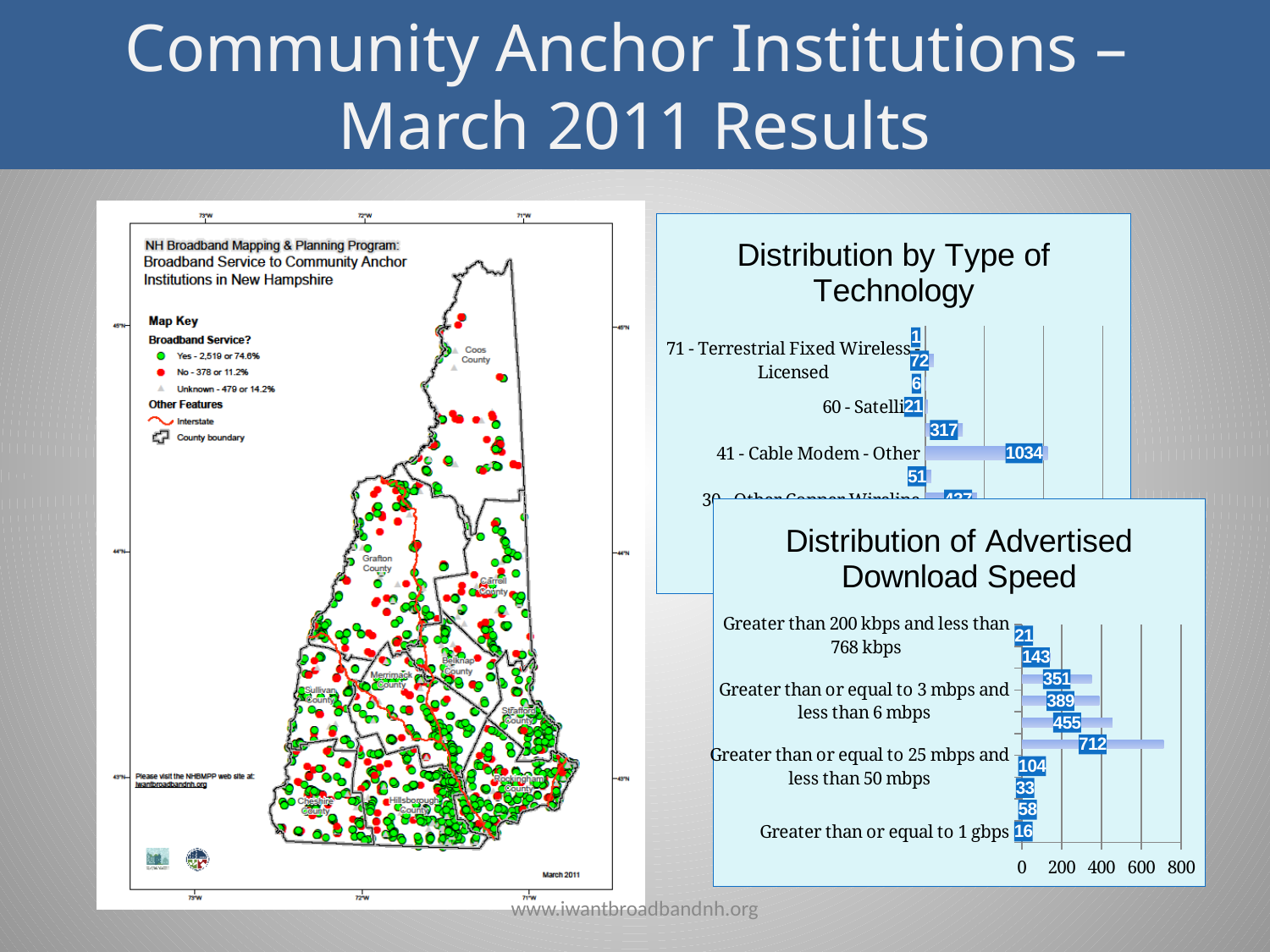
What kind of chart is the 'Distribution of Advertised Download Speed' chart? bar chart In the 'Distribution of Advertised Download Speed' chart, what is the value for 'Greater than or equal to 1 gbps'? 16 In the 'Distribution of Advertised Download Speed' chart, what is the value for 'Greater than 200 kbps and less than 768 kbps'? 21 In the 'Distribution of Advertised Download Speed' chart, what is the value for 'Greater than or equal to 3 mbps and less than 6 mbps'? 389 In the 'Distribution of Advertised Download Speed' chart, what is the value for 'Greater than or equal to 25 mbps and less than 50 mbps'? 104 In the 'Distribution of Advertised Download Speed' chart, is the longest bar greater or less than 600? greater In the 'Distribution of Advertised Download Speed' chart, which labelled category has the lowest value? Greater than or equal to 1 gbps How many bars are plotted in the 'Distribution of Advertised Download Speed' chart? 10 In the 'Distribution of Advertised Download Speed' chart, what is the difference between the values for 'Greater than or equal to 3 mbps and less than 6 mbps' and 'Greater than or equal to 25 mbps and less than 50 mbps'? 285 In the 'Distribution by Type of Technology' chart, what is the value for '41 - Cable Modem - Other'? 1034 In the 'Distribution of Advertised Download Speed' chart, which is larger: the value for 'Greater than or equal to 3 mbps and less than 6 mbps' or for 'Greater than or equal to 1 gbps'? Greater than or equal to 3 mbps and less than 6 mbps In the 'Distribution of Advertised Download Speed' chart, what is the largest value shown on any bar? 712